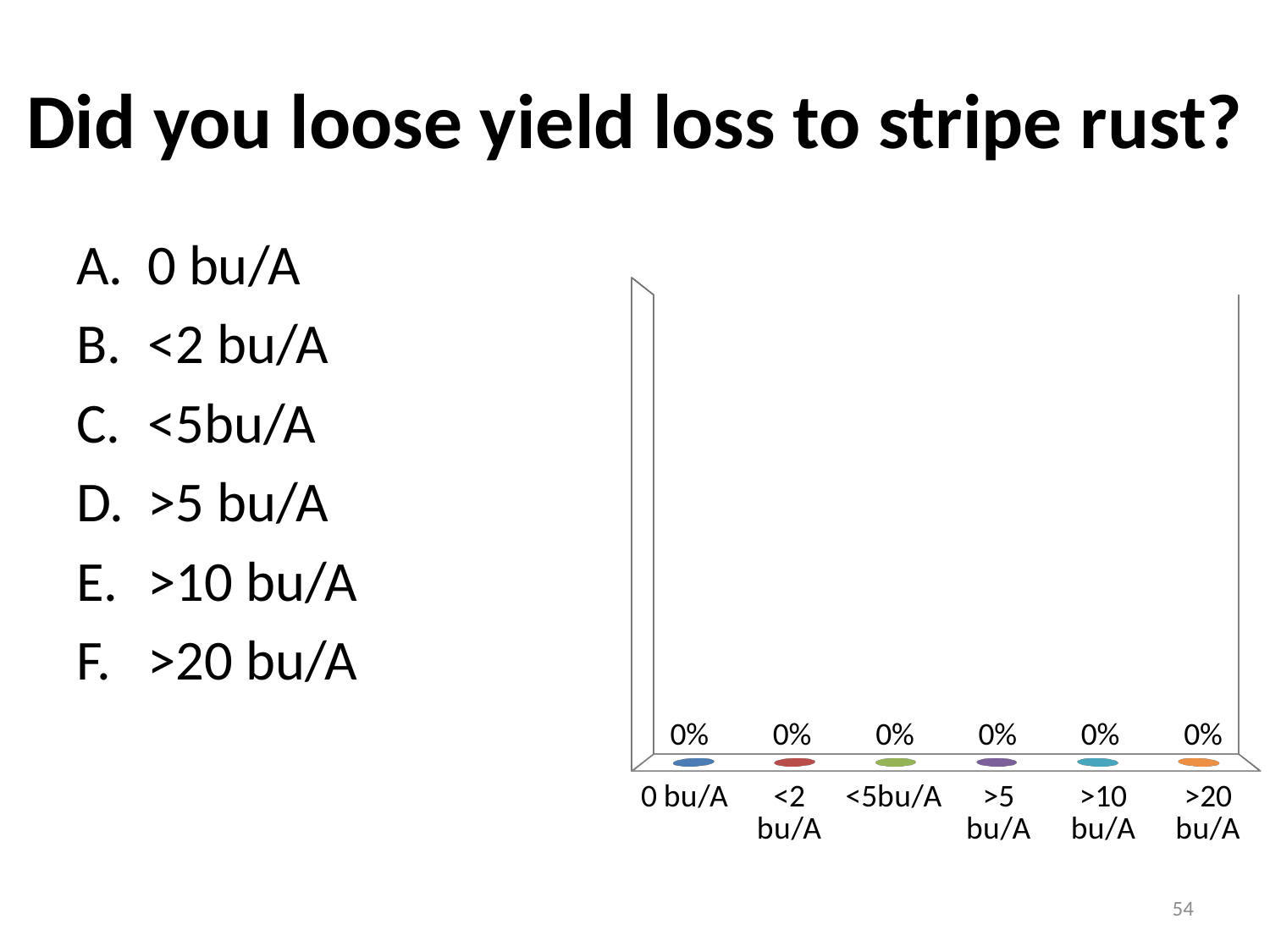
What is the value for >20 bu/A? 0% Do the values rise, fall, or stay flat from 0 bu/A to >20 bu/A? stay flat What kind of chart is shown on the slide? bar chart What colour is the marker for the >20 bu/A category? orange What is the difference between the values for 0 bu/A and >20 bu/A? 0% What is the value for 0 bu/A? 0% What is the value for >5 bu/A? 0% How many categories are shown on the x axis of the chart? 6 What is the value for <2 bu/A? 0% What is the value for >10 bu/A? 0% What is the value for <5bu/A? 0% What is the label of the first category on the x axis? 0 bu/A